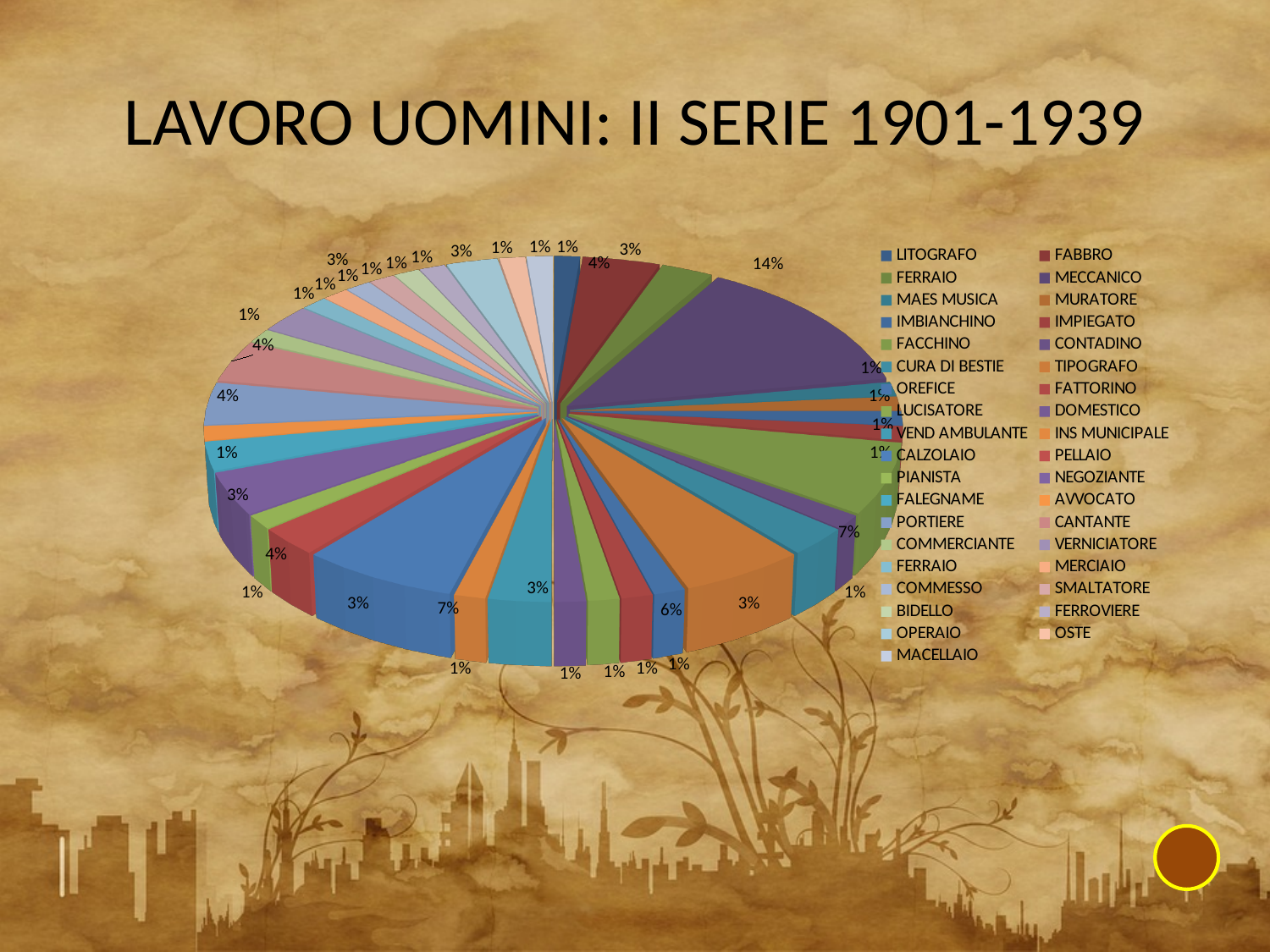
What is the percentage shown on the largest slice of the pie chart? 14% How many slices of the pie chart are labelled 14%? 1 Which is larger in the pie chart: the 14% slice or a 7% slice? the 14% slice What kind of chart is shown on the slide? pie chart How many slices of the pie chart are labelled 7%? 2 What is the smallest percentage value labelled on any slice of the pie chart? 1% What is the title of the chart on the slide? LAVORO UOMINI: II SERIE 1901-1939 How many categories does the legend of the pie chart list? 37 Which category has the largest slice in the pie chart? MECCANICO What is the first entry listed in the chart's legend? LITOGRAFO What is the difference between the largest slice (14%) and the second-largest slice (7%) in the pie chart? 7%